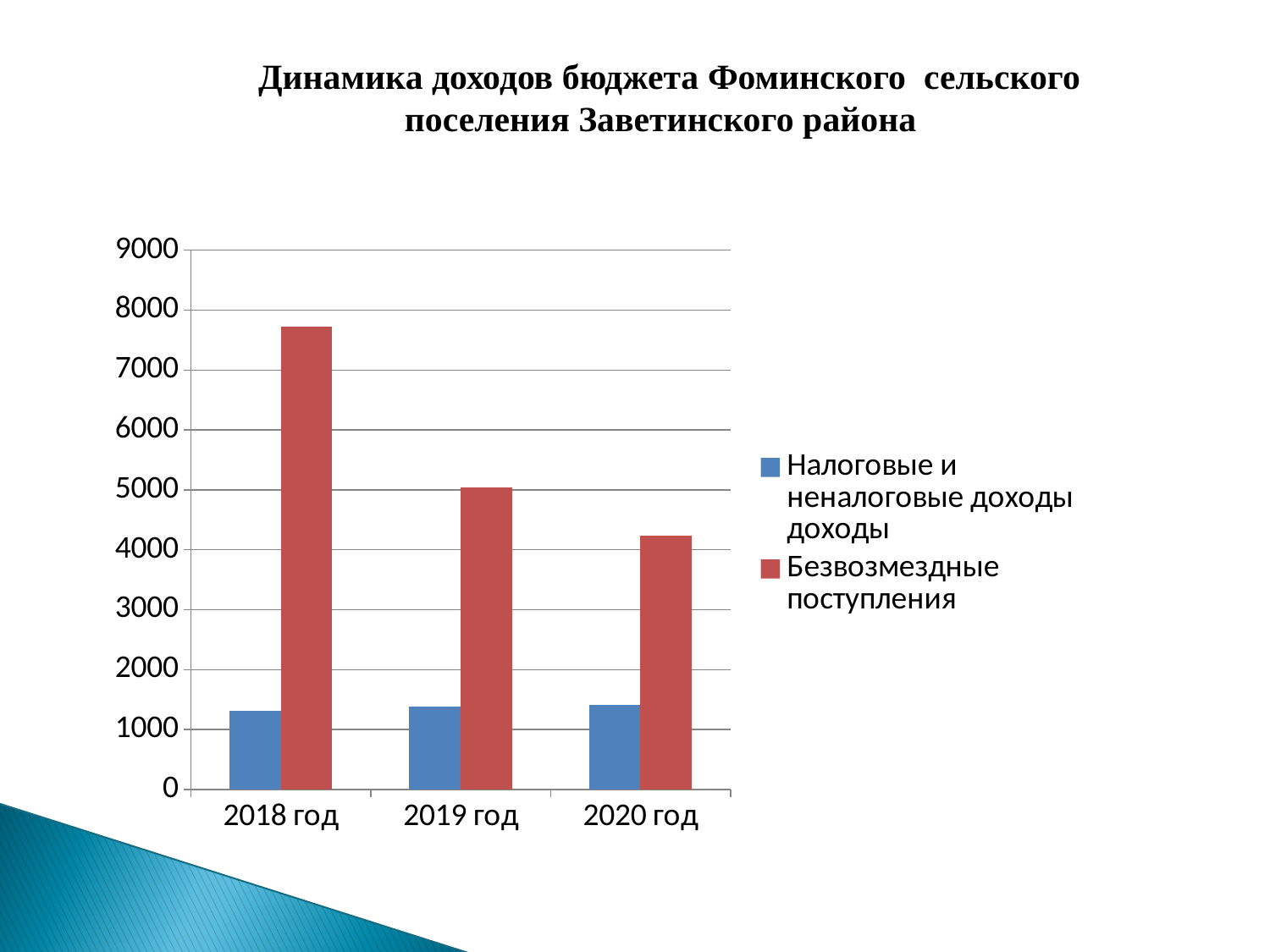
Is the value for Безвозмездные поступления in 2019 год greater or less than 6000? less In which year is the value for Безвозмездные поступления lowest? 2020 год In which year is the value for Безвозмездные поступления highest? 2018 год Which is larger in 2019 год: Налоговые и неналоговые доходы or Безвозмездные поступления? Безвозмездные поступления Do the values for Безвозмездные поступления rise or fall from 2018 год to 2020 год? fall Is the value for Безвозмездные поступления in 2018 год greater or less than 7000? greater What colour are the bars for Безвозмездные поступления? red How many series does the legend list? 2 How many years are shown on the x axis? 3 Is the value for Налоговые и неналоговые доходы in 2020 год greater or less than 1000? greater What kind of chart is shown on the slide? bar chart